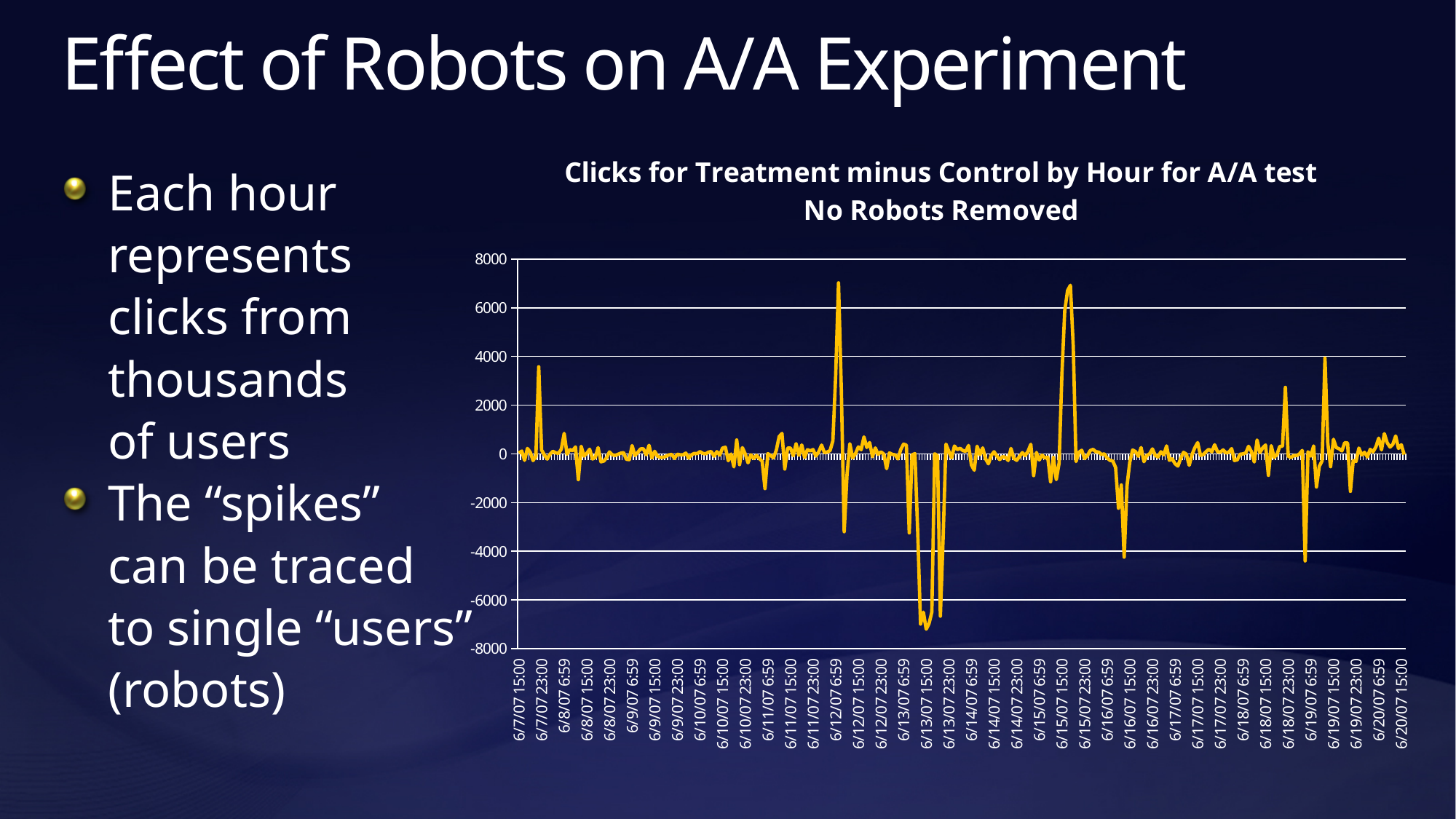
Is the peak of the spike near 6/15/07 15:00 greater or less than 6000? greater What is the title of the chart? Clicks for Treatment minus Control by Hour for A/A test No Robots Removed What is the last date-time label on the chart's horizontal axis? 6/20/07 15:00 What is the highest value shown on the chart's vertical axis? 8000 What is the first date-time label on the chart's horizontal axis? 6/7/07 15:00 What kind of chart is shown on the slide? line chart Is the lowest point of the dip near 6/13/07 15:00 greater or less than -6000? less What is the lowest value shown on the chart's vertical axis? -8000 Around which date does the line reach its lowest value? 6/13/07 Is the peak of the spike near 6/12/07 6:59 greater or less than 6000? greater Which spike reaches a higher value: the one near 6/12/07 6:59 or the one near 6/7/07 23:00? 6/12/07 6:59